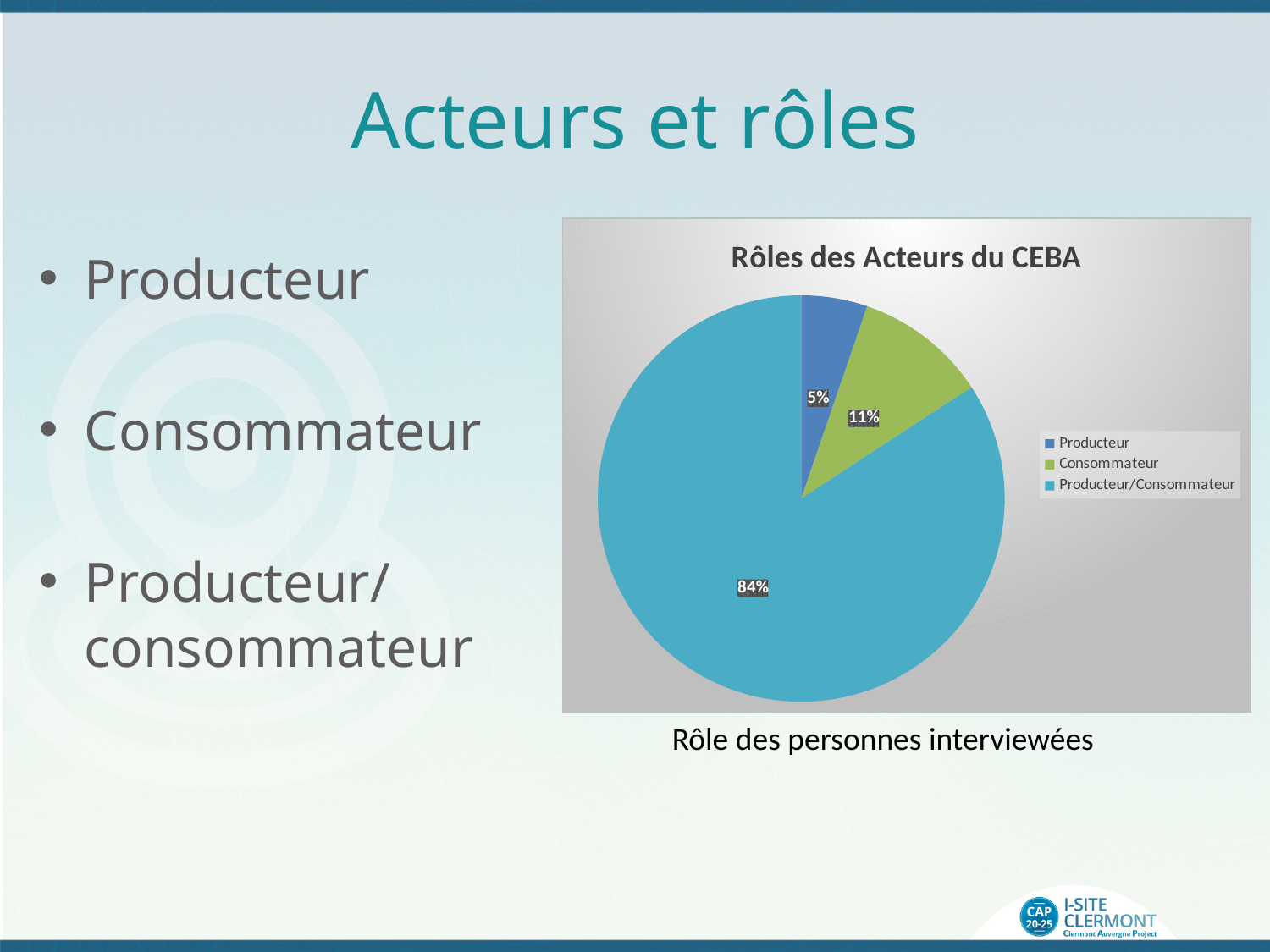
What share of the pie does Producteur/Consommateur represent? 84% Which is larger, the Consommateur slice or the Producteur slice? Consommateur Which category has the smallest slice of the pie? Producteur What is the difference in percentage points between the Producteur/Consommateur and Consommateur slices? 73% How many categories are shown in the pie chart? 3 What kind of chart is shown on the slide? Pie chart What colour is the Consommateur slice in the pie chart? Green What is the title of the chart? Rôles des Acteurs du CEBA What is the difference in percentage points between the Consommateur and Producteur slices? 6% What share of the pie does Consommateur represent? 11% What share of the pie does Producteur represent? 5% Which category has the largest slice of the pie? Producteur/Consommateur